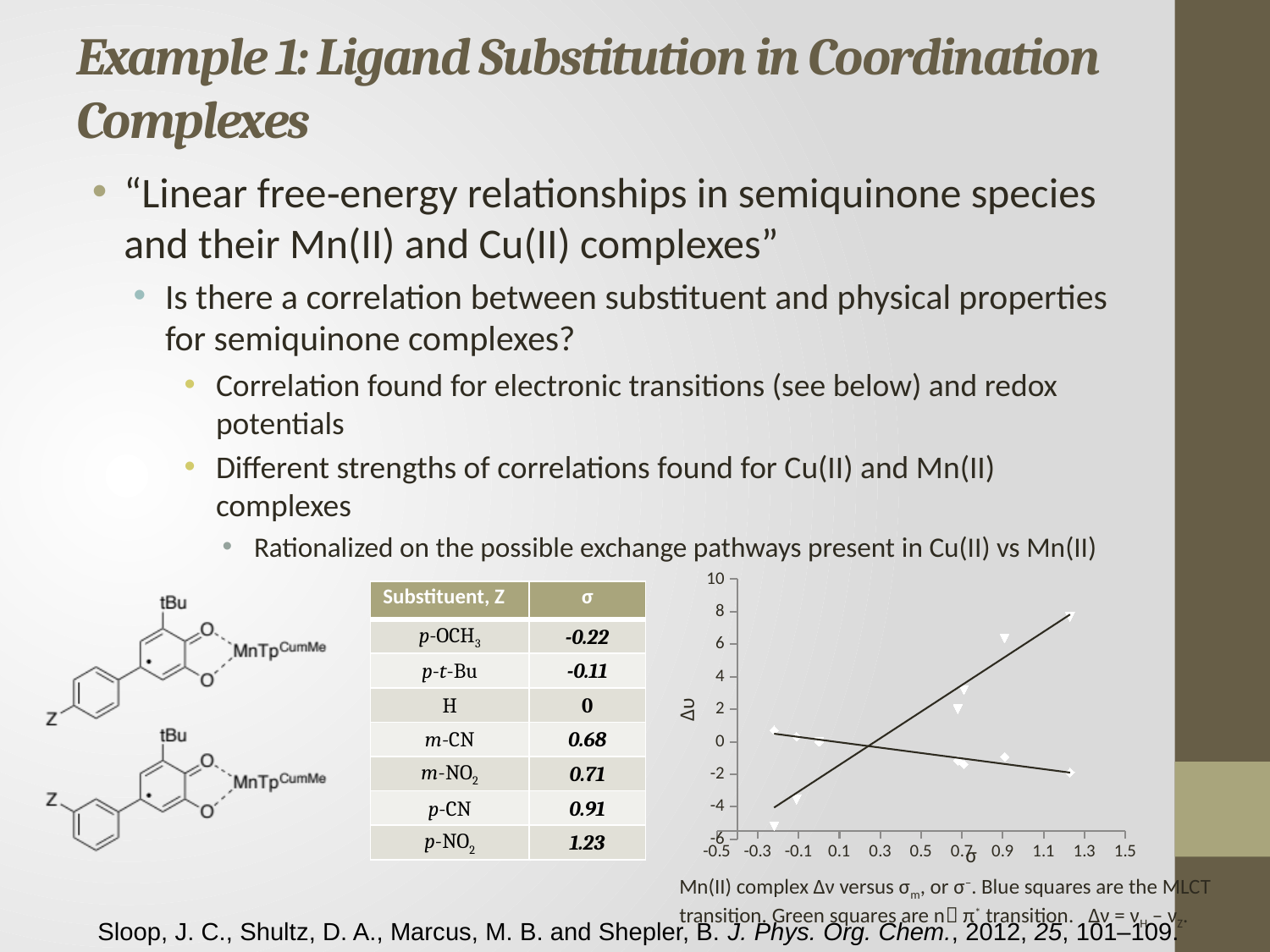
What kind of chart is shown on the slide? scatter chart How many trend lines are drawn on the chart? 2 What is the label on the y axis of the chart? Δν Is the lowest plotted Δν value on the chart greater or less than -4? less Is the highest plotted Δν value on the chart greater or less than 6? greater Does the shallower trend line on the chart rise or fall as σ increases? fall Does the steeper trend line on the chart rise or fall as σ increases? rise At the rightmost plotted σ value, is the point on the rising trend line above or below the point on the falling trend line? above What is the label on the x axis of the chart? σ At the leftmost plotted σ value, is the point on the rising trend line above or below the point on the falling trend line? below